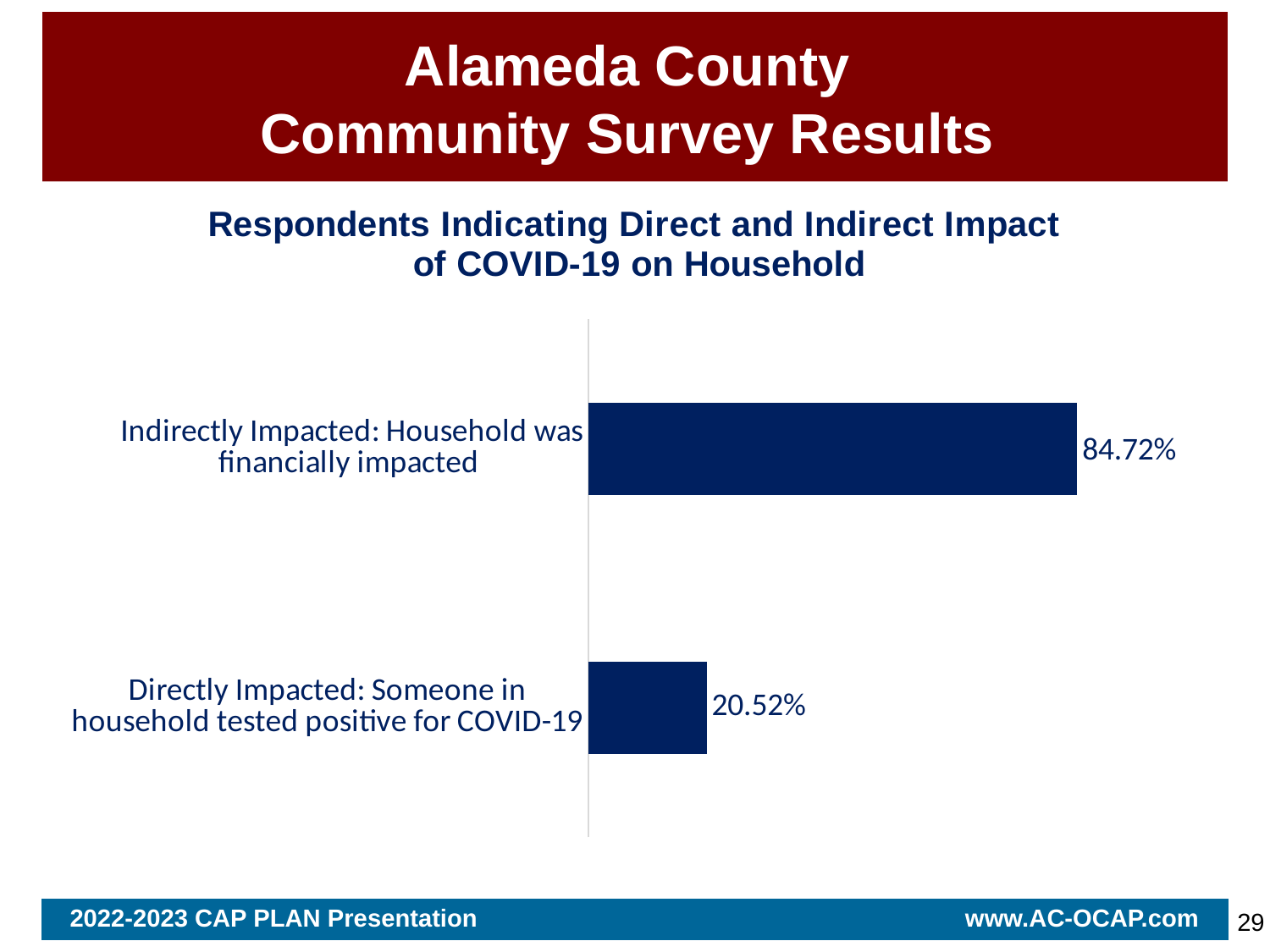
Which is larger: the percentage indirectly impacted or the percentage directly impacted? Indirectly Impacted What percentage of respondents were directly impacted (someone in household tested positive for COVID-19)? 20.52% What is the difference between the indirectly impacted and directly impacted percentages? 64.20% Which category has the lowest value? Directly Impacted: Someone in household tested positive for COVID-19 What percentage of respondents were indirectly impacted (household was financially impacted)? 84.72% What kind of chart is shown on the slide? Bar chart What colour are the bars in the chart? Dark blue What is the title of the chart? Respondents Indicating Direct and Indirect Impact of COVID-19 on Household Which category has the highest value? Indirectly Impacted: Household was financially impacted How many categories are shown in the chart? 2